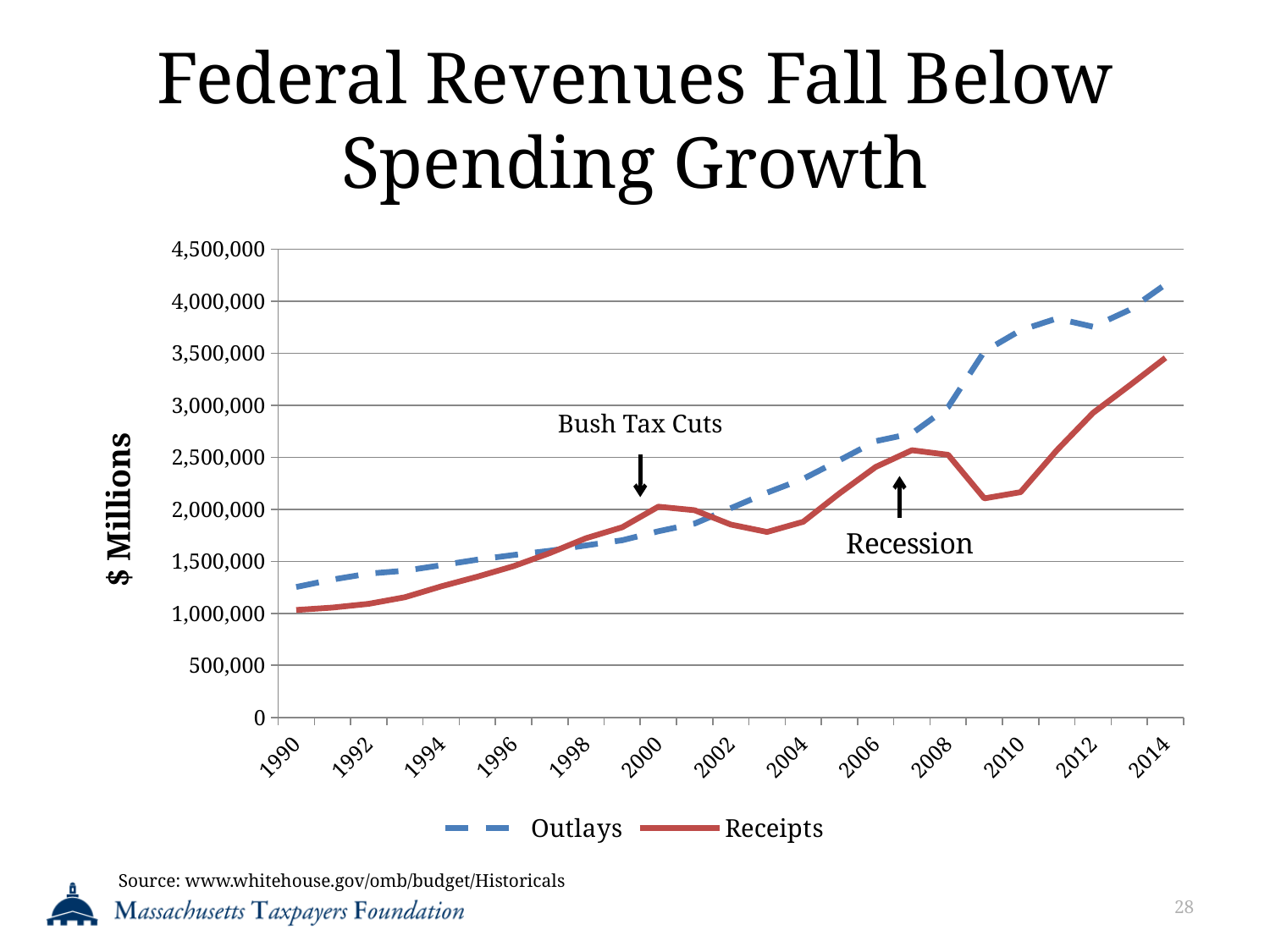
How many series does the legend list? 2 In 2000, which is larger, Outlays or Receipts? Receipts Is the value for Receipts in 1990 greater or less than 1,500,000? less Is the value for Receipts in 2014 greater or less than 4,000,000? less What kind of chart is shown on the slide? Line chart Is the value for Receipts in 2000 greater or less than 1,500,000? greater What is the label on the vertical axis? $ Millions Do Outlays generally rise or fall from 1990 to 2014? Rise In 2010, which is larger, Outlays or Receipts? Outlays Which series is drawn with a dashed line? Outlays Do Receipts rise or fall between 2007 and 2009? Fall